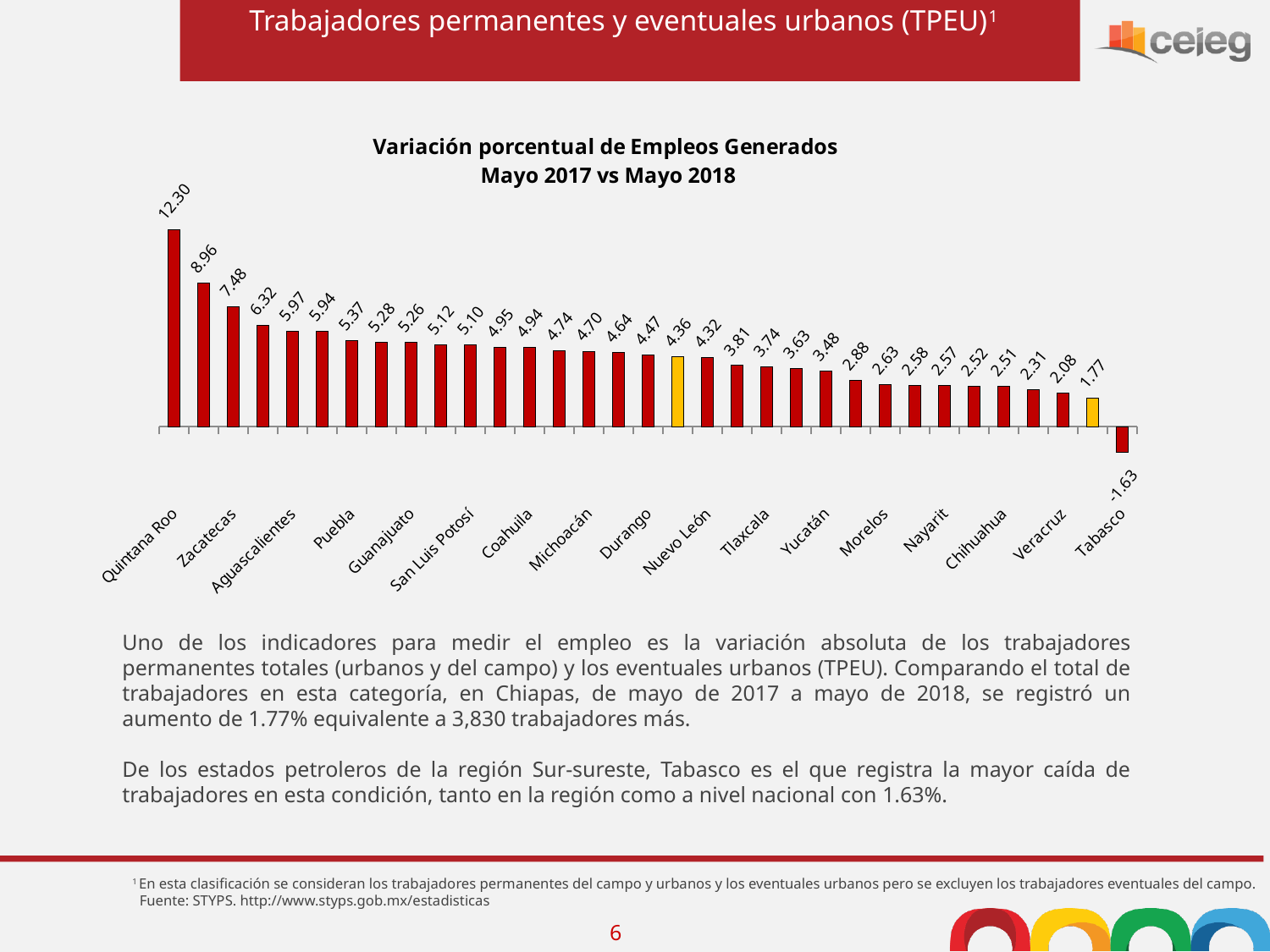
Which is larger, the value for Quintana Roo or the value for Zacatecas? Quintana Roo What is the difference between the values for Quintana Roo and Zacatecas? 4.82 How many bars in the chart have a negative value? 1 What is the value shown for Zacatecas? 7.48 Do the values rise or fall from left to right along the x axis? fall What is the value shown for Tabasco? -1.63 What is the value shown for Quintana Roo? 12.30 What kind of chart is shown on the slide? bar chart What is the title of the chart? Variación porcentual de Empleos Generados Mayo 2017 vs Mayo 2018 How many bars are plotted in the chart? 33 Which state has the lowest percentage variation in the chart? Tabasco Which state has the highest percentage variation in the chart? Quintana Roo